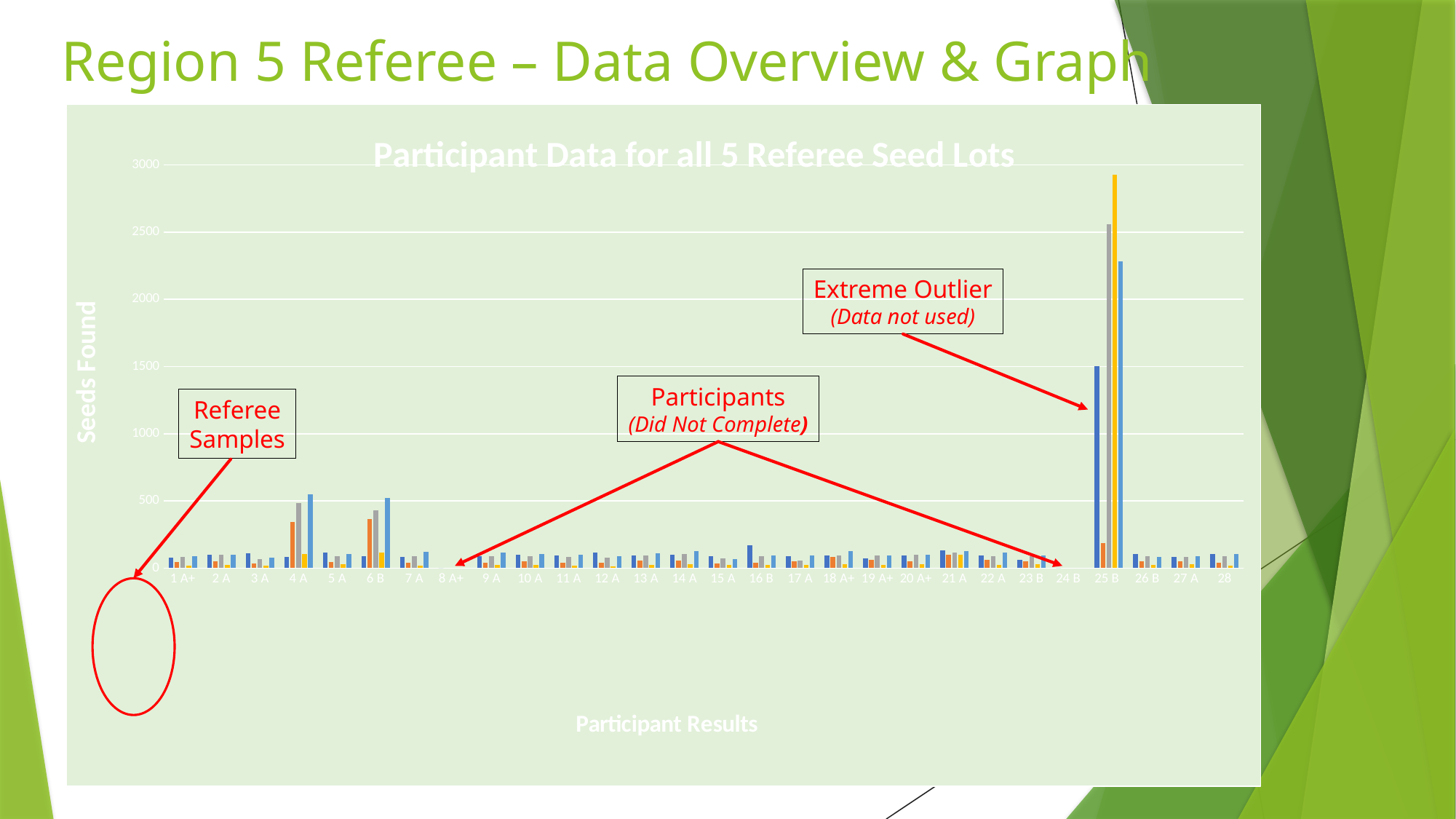
What is the title of the chart? Participant Data for all 5 Referee Seed Lots How many participant categories are shown along the x axis? 28 What is the highest value shown on the vertical axis of the chart? 3000 What kind of chart is shown on the slide? bar chart Are the bars for participant 4 A taller or shorter than the bars for participant 3 A? taller What is the label on the vertical axis of the chart? Seeds Found Is the tallest bar for participant 16 B greater or less than 500? less Is the tallest bar for participant 25 B greater or less than 2500? greater Are the bars for participant 25 B taller or shorter than the bars for participant 26 B? taller Is the tallest bar for participant 6 B greater or less than 1000? less Which participant category has the tallest bars in the chart? 25 B